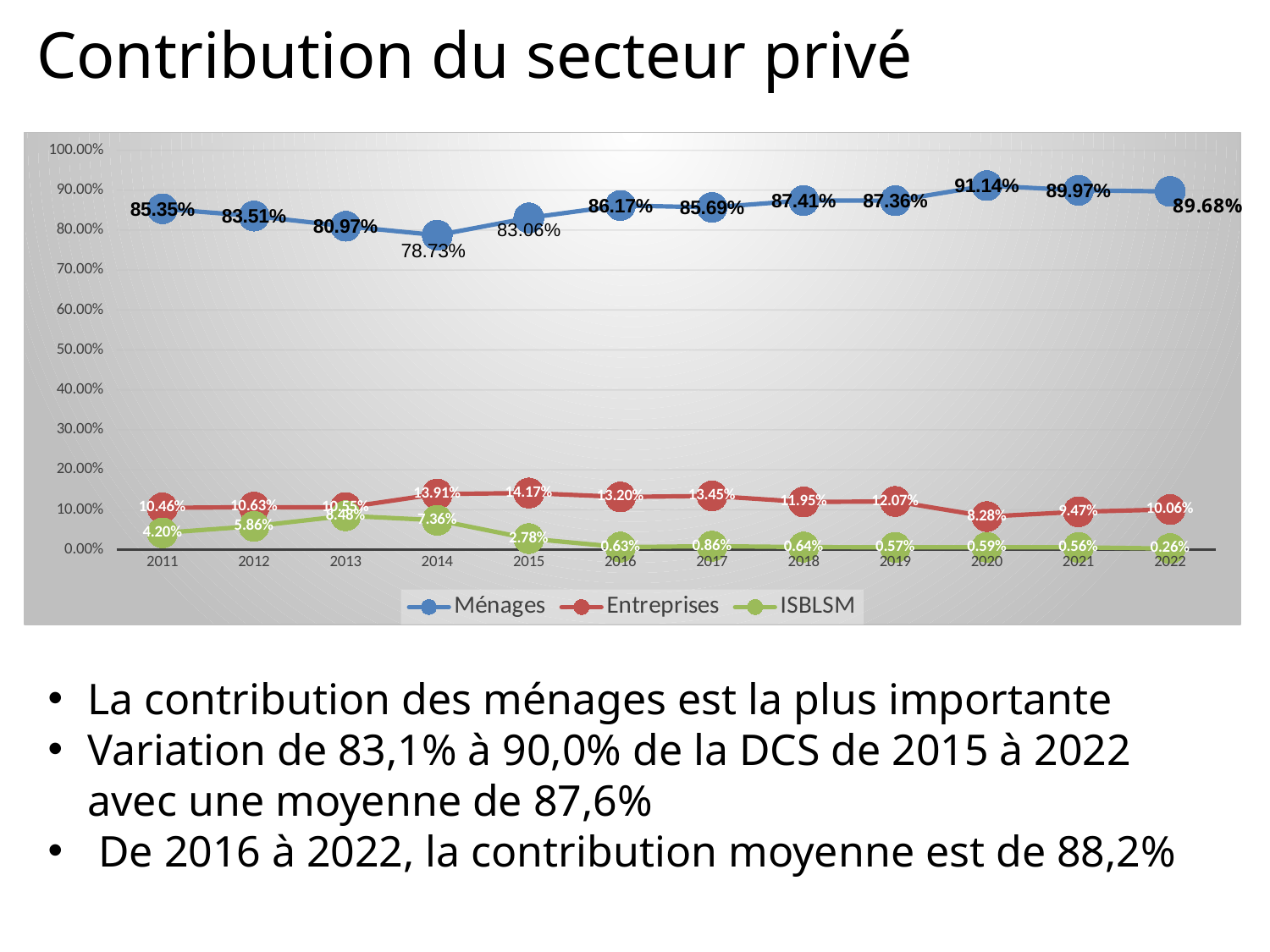
What is the value for Entreprises in 2015? 14.17% What is the value for ISBLSM in 2013? 8.48% How many years are shown on the x axis? 12 In which year is the Ménages value highest? 2020 How many series does the legend list? 3 Which is larger in 2020: the Entreprises value or the ISBLSM value? Entreprises What is the difference between the Ménages values in 2020 and 2014? 12.41% Which series is plotted in blue? Ménages In which year is the ISBLSM value lowest? 2022 What type of chart is shown on the slide? line chart What is the value for Ménages in 2014? 78.73% In which year is the Ménages value lowest? 2014